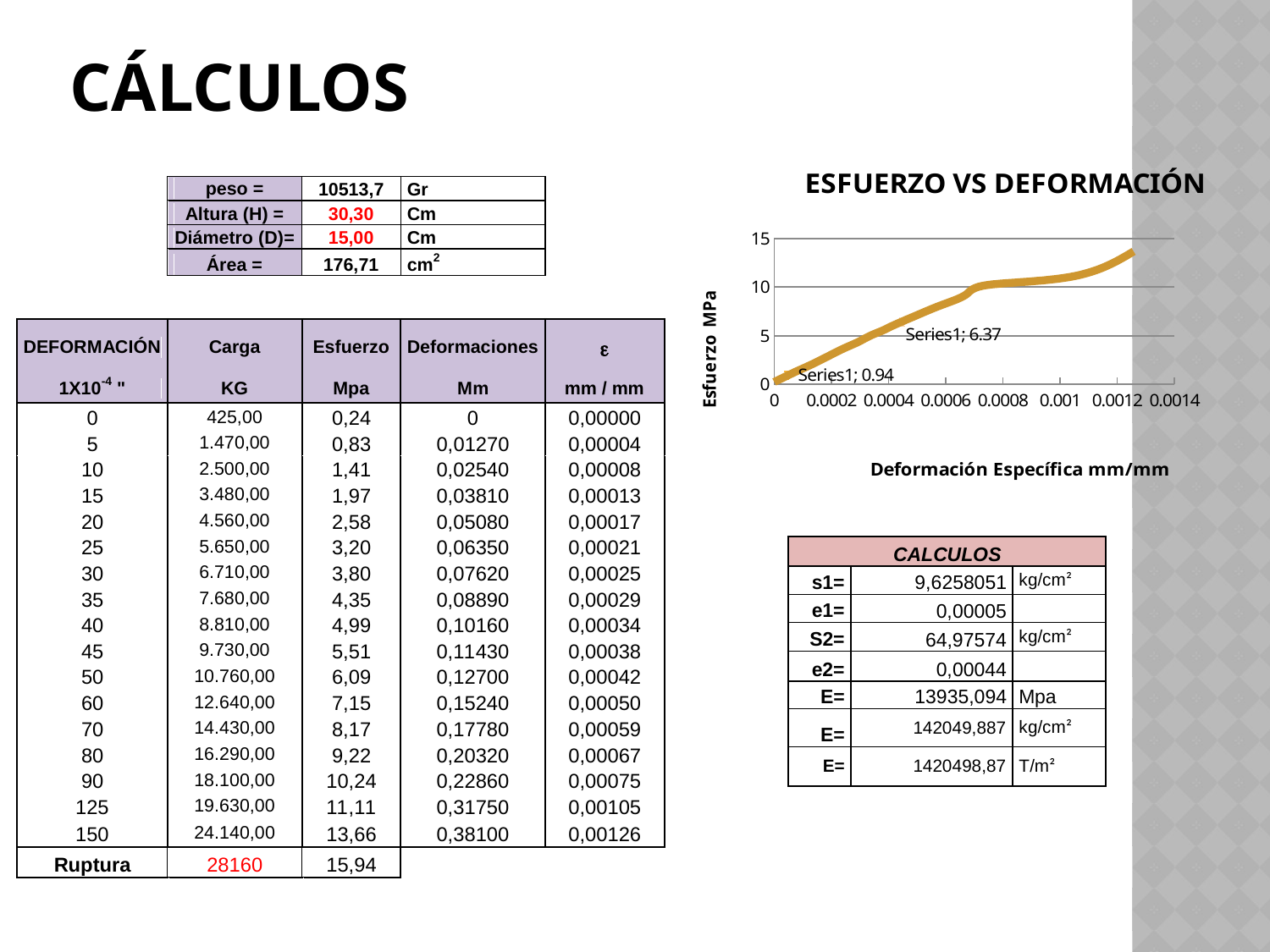
What is the highest tick value shown on the vertical axis of the chart? 15 In the ESFUERZO VS DEFORMACIÓN chart, is the value of the line at a deformation of 0.0012 greater or less than 10? greater What is the larger of the two data label values printed on the line in the chart? 6.37 What kind of chart is shown under the title ESFUERZO VS DEFORMACIÓN? line chart What is the title of the chart on the slide? ESFUERZO VS DEFORMACIÓN In the ESFUERZO VS DEFORMACIÓN chart, is the value of the line at a deformation of 0.0002 greater or less than 5? less How many lines (series) are plotted in the ESFUERZO VS DEFORMACIÓN chart? 1 What value does the data label near the start of the line show? 0.94 Does the line in the ESFUERZO VS DEFORMACIÓN chart rise or fall as deformation increases along the x axis? rise What is the label of the vertical axis of the chart? Esfuerzo MPa How many tick labels are shown along the x axis of the ESFUERZO VS DEFORMACIÓN chart? 8